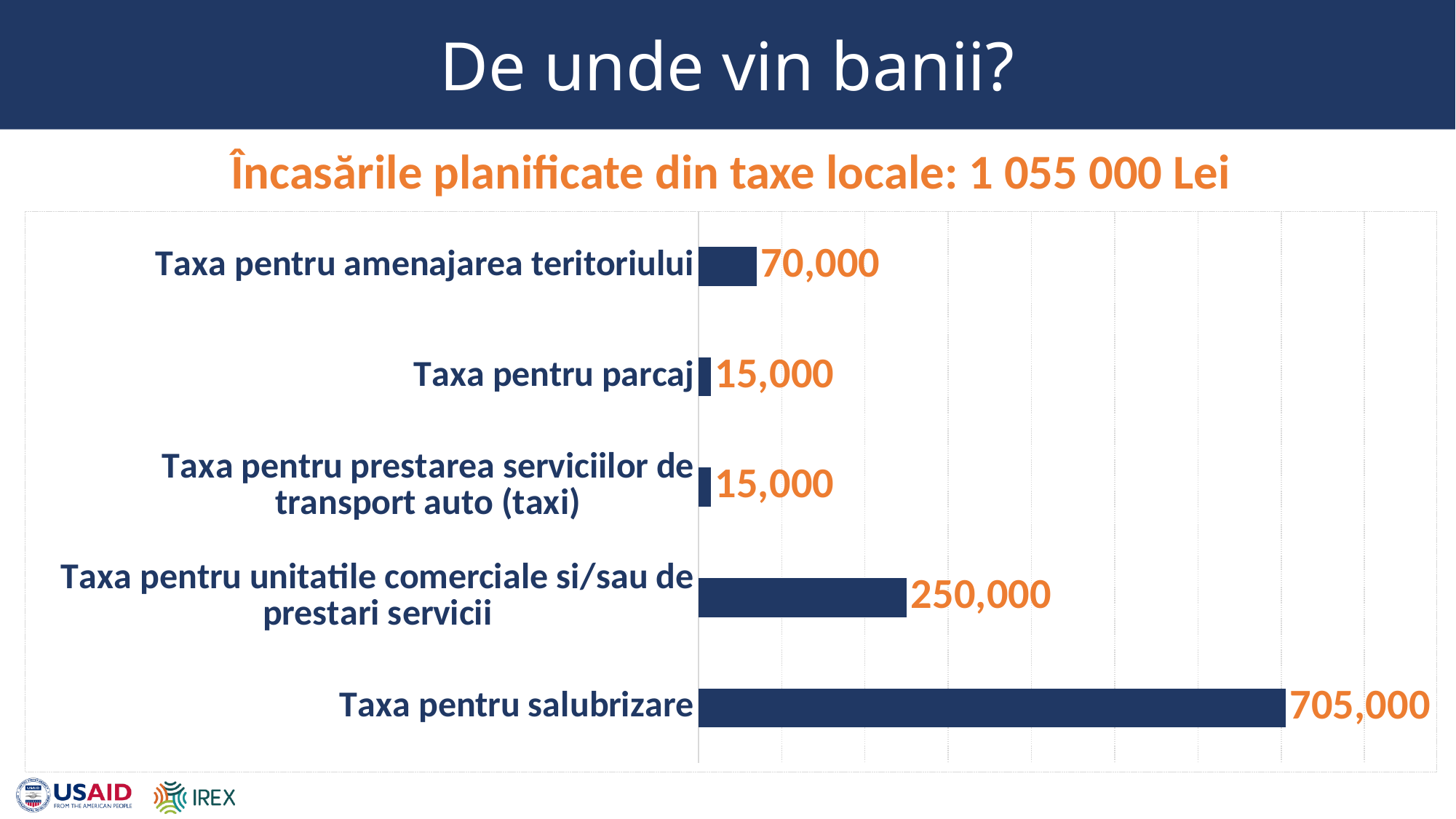
What is the value for Taxa pentru parcaj? 15,000 What kind of chart is shown on the slide? Bar chart Which is larger, Taxa pentru amenajarea teritoriului or Taxa pentru unitatile comerciale si/sau de prestari servicii? Taxa pentru unitatile comerciale si/sau de prestari servicii Which category has the highest value? Taxa pentru salubrizare What is the total of all the values shown in the chart? 1,055,000 What is the title of the chart? Încasările planificate din taxe locale: 1 055 000 Lei What is the value for Taxa pentru salubrizare? 705,000 How many categories are shown in the chart? 5 What is the value for Taxa pentru amenajarea teritoriului? 70,000 What is the value for Taxa pentru unitatile comerciale si/sau de prestari servicii? 250,000 What is the difference between Taxa pentru salubrizare and Taxa pentru unitatile comerciale si/sau de prestari servicii? 455,000 What is the difference between Taxa pentru amenajarea teritoriului and Taxa pentru parcaj? 55,000